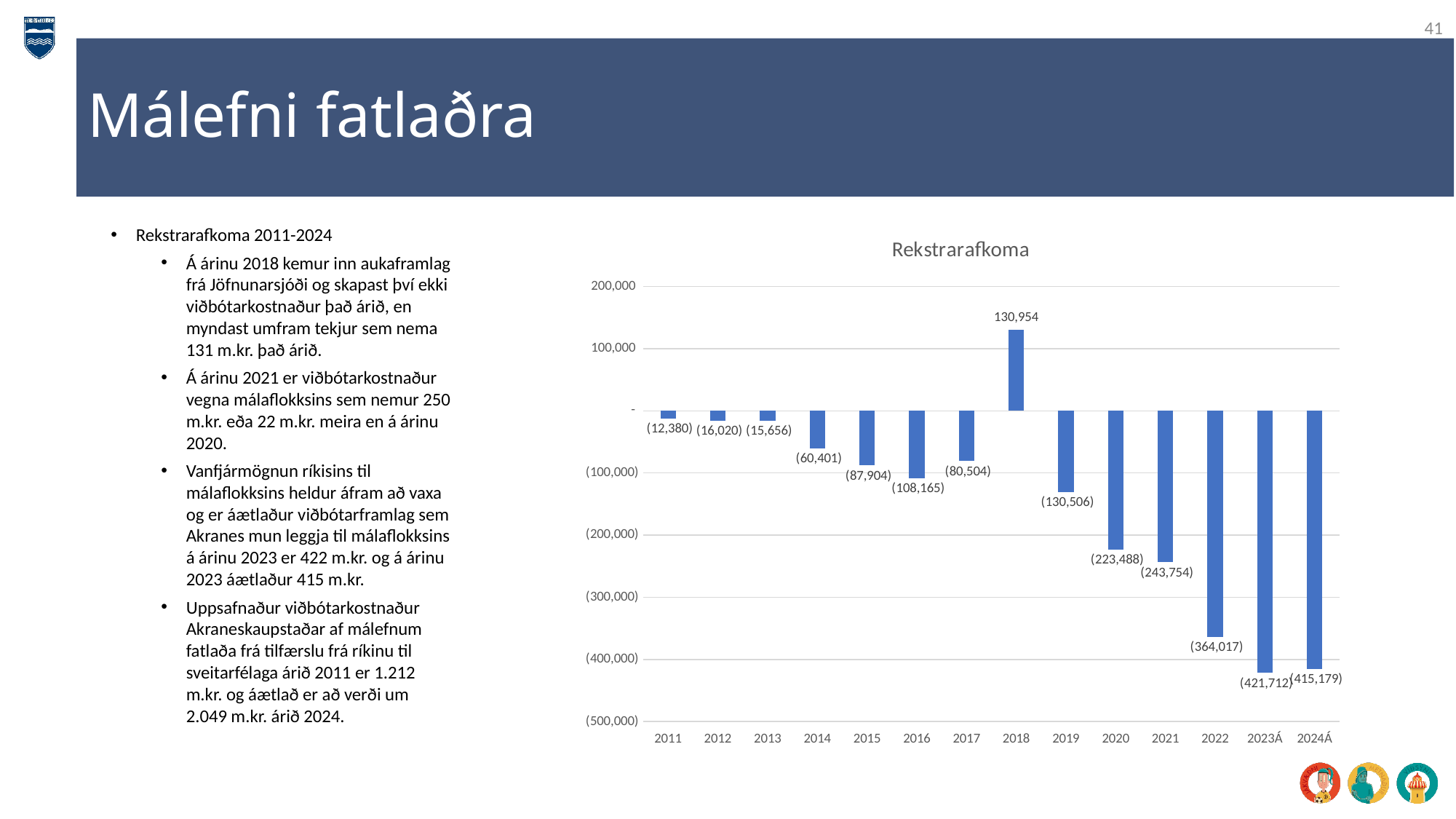
What is the value for 2020 in the Rekstrarafkoma chart? (223,488) In the Rekstrarafkoma chart, which bar extends further below zero, 2015 or 2017? 2015 By how much does the value for 2023Á differ from the value for 2024Á in the Rekstrarafkoma chart? 6,533 By how much does the value for 2021 differ from the value for 2020 in the Rekstrarafkoma chart? 20,266 What is the value for 2011 in the Rekstrarafkoma chart? (12,380) Which year has the lowest value in the Rekstrarafkoma chart? 2023Á What is the value for 2018 in the Rekstrarafkoma chart? 130,954 What kind of chart is the Rekstrarafkoma chart? bar chart Which year has the highest value in the Rekstrarafkoma chart? 2018 What is the value for 2023Á in the Rekstrarafkoma chart? (421,712) How many years are shown on the x axis of the Rekstrarafkoma chart? 14 Is the value for 2018 in the Rekstrarafkoma chart greater or less than 100,000? greater